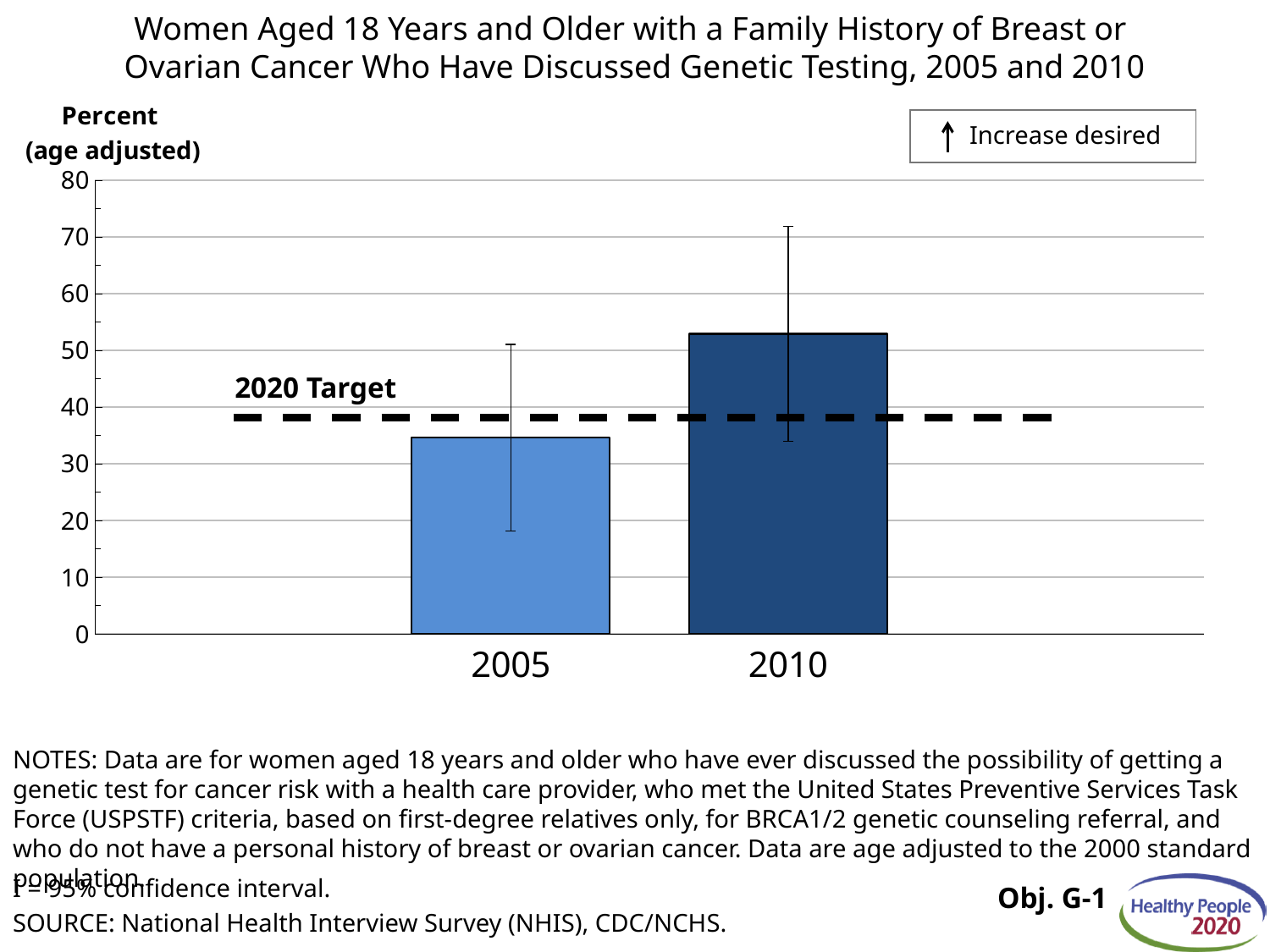
Is the value for 2010 greater or less than 50? greater Which year has the highest value in the chart? 2010 What does the dashed horizontal line in the chart represent? 2020 Target Which year has the lowest value in the chart? 2005 Is the value for 2010 greater or less than 60? less What is the label of the y axis? Percent (age adjusted) Does the value rise or fall from 2005 to 2010? rise Which year has the higher value, 2005 or 2010? 2010 How many bars (years) are plotted in the chart? 2 Is the value for 2005 greater or less than 30? greater What kind of chart is shown on the slide? bar chart